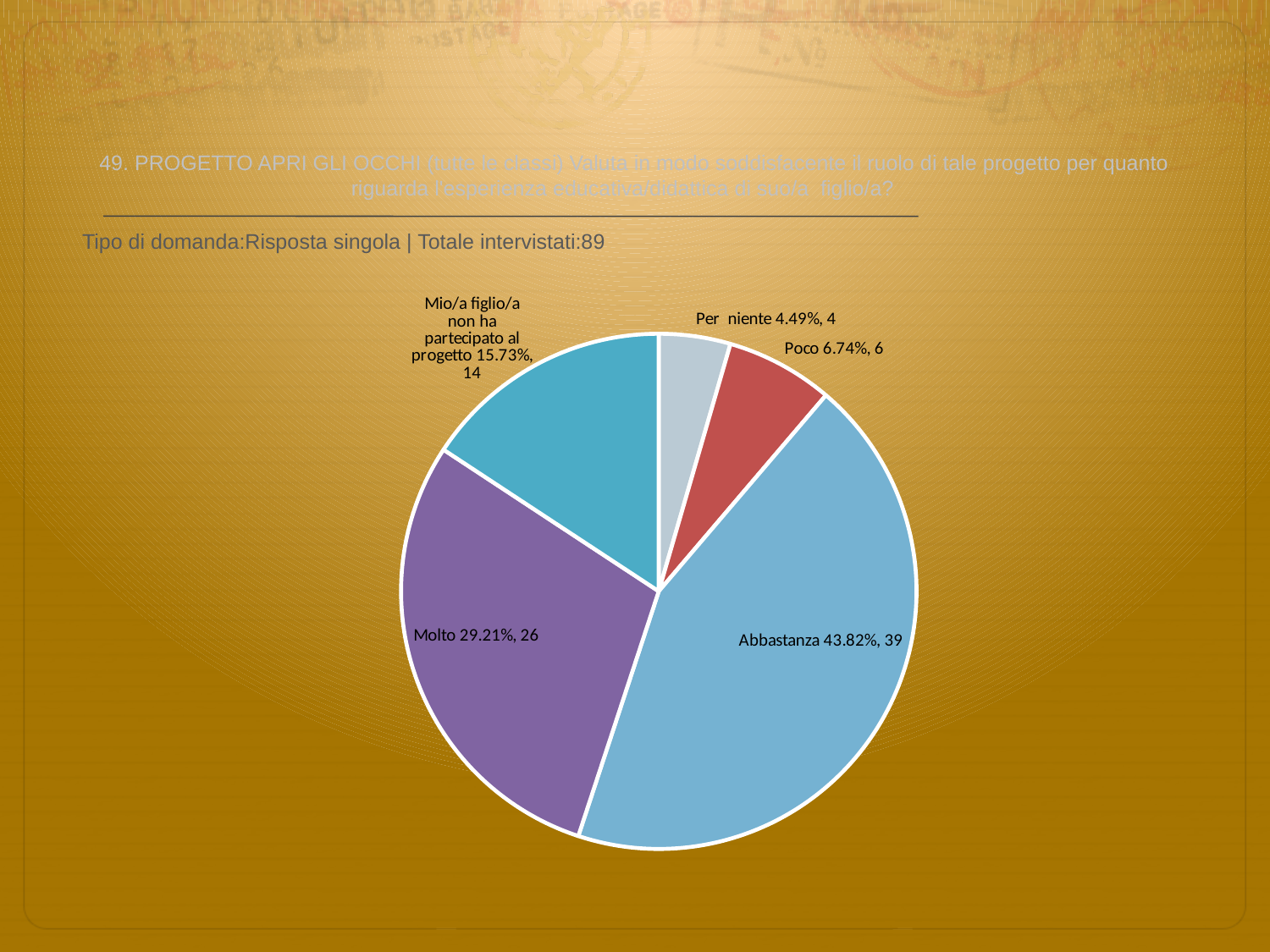
What is the count for the 'Poco' slice? 6 Which category has the smallest slice? Per niente What is the count for the 'Abbastanza' slice? 39 What kind of chart is shown on the slide? pie chart What percentage share does the 'Per niente' slice have? 4.49% Which category has the largest slice? Abbastanza What is the count for the 'Mio/a figlio/a non ha partecipato al progetto' slice? 14 How many slices does the pie chart have? 5 Which is larger, the count for 'Poco' or the count for 'Per niente'? Poco What is the difference in count between 'Abbastanza' and 'Molto'? 13 What is the total number of respondents stated on the slide? 89 What percentage share does the 'Molto' slice have? 29.21%